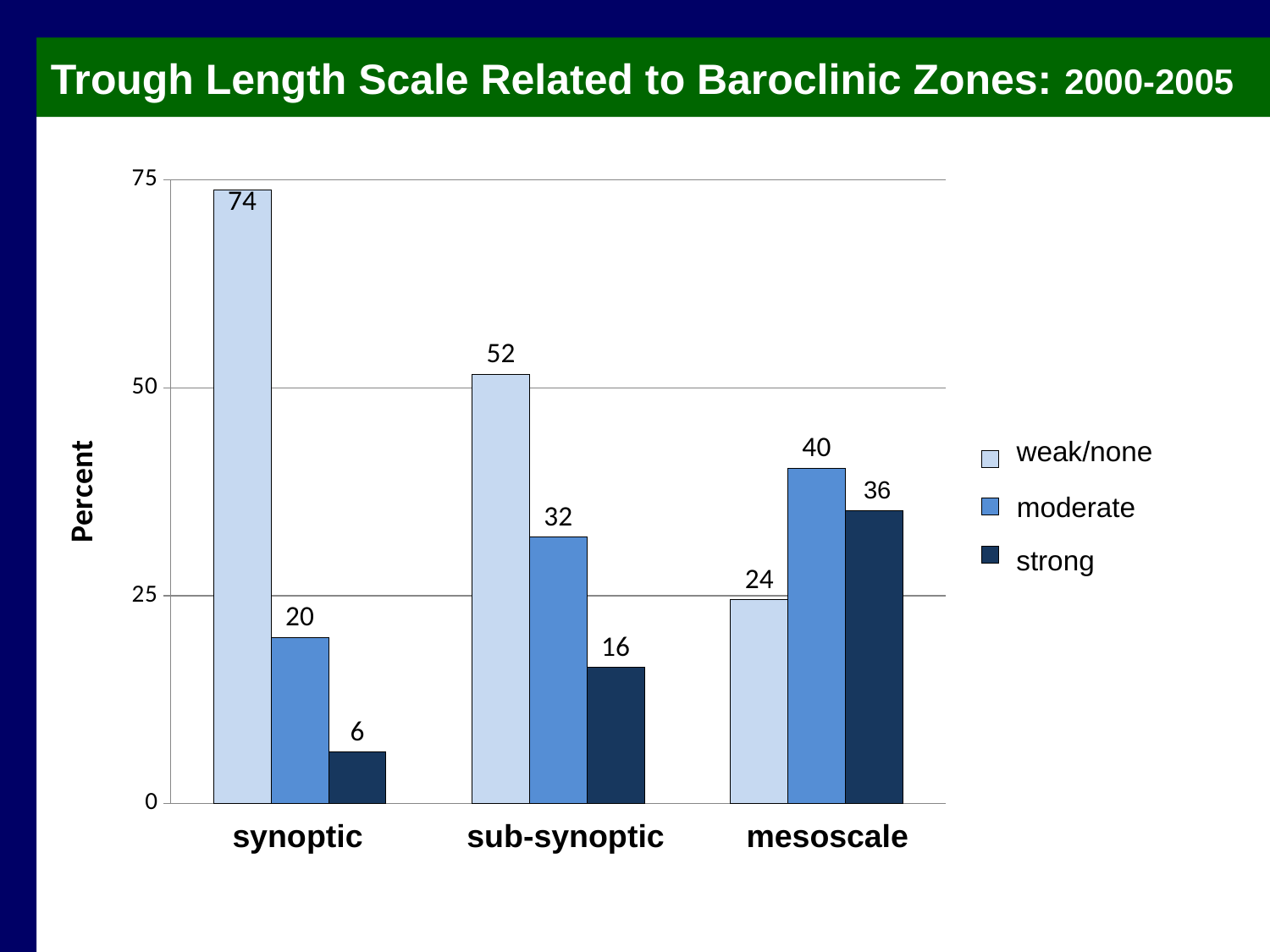
Which is larger for mesoscale, the moderate value or the strong value? moderate What is the label of the y axis? Percent What is the strong value for sub-synoptic? 16 How many series does the legend list? 3 What is the difference between the weak/none and moderate values for synoptic? 54 Which category has the lowest strong value? synoptic What is the weak/none value for synoptic? 74 How many categories are shown on the x axis? 3 Is the weak/none value for sub-synoptic greater or less than 50? greater What is the moderate value for mesoscale? 40 What kind of chart is shown? bar chart Which category has the highest weak/none value? synoptic